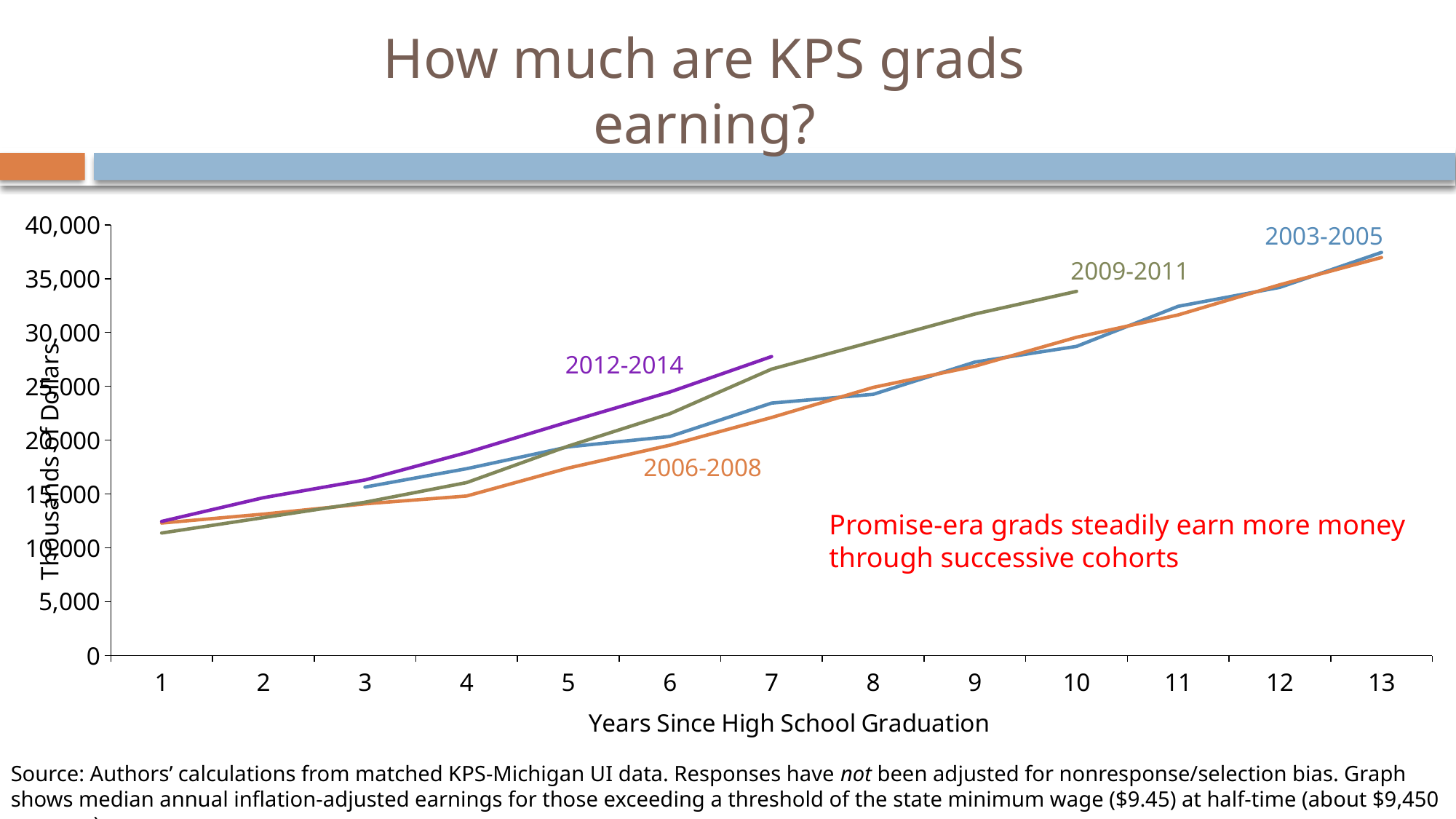
How many years since high school graduation are marked along the x axis? 13 Which cohort's line ends at the earliest year since graduation? 2012-2014 Is the value for the 2003-2005 cohort at year 13 greater or less than 35,000? greater What is the title of the x axis? Years Since High School Graduation How many cohort series are plotted on the chart? 4 At year 7, which cohort has higher earnings, 2012-2014 or 2006-2008? 2012-2014 What kind of chart is shown on the slide? line chart Is the value for the 2006-2008 cohort at year 1 greater or less than 15,000? less At year 10, which cohort has higher earnings, 2009-2011 or 2003-2005? 2009-2011 Is the value for the 2012-2014 cohort at year 7 greater or less than 25,000? greater Do earnings rise or fall as years since high school graduation increase? rise